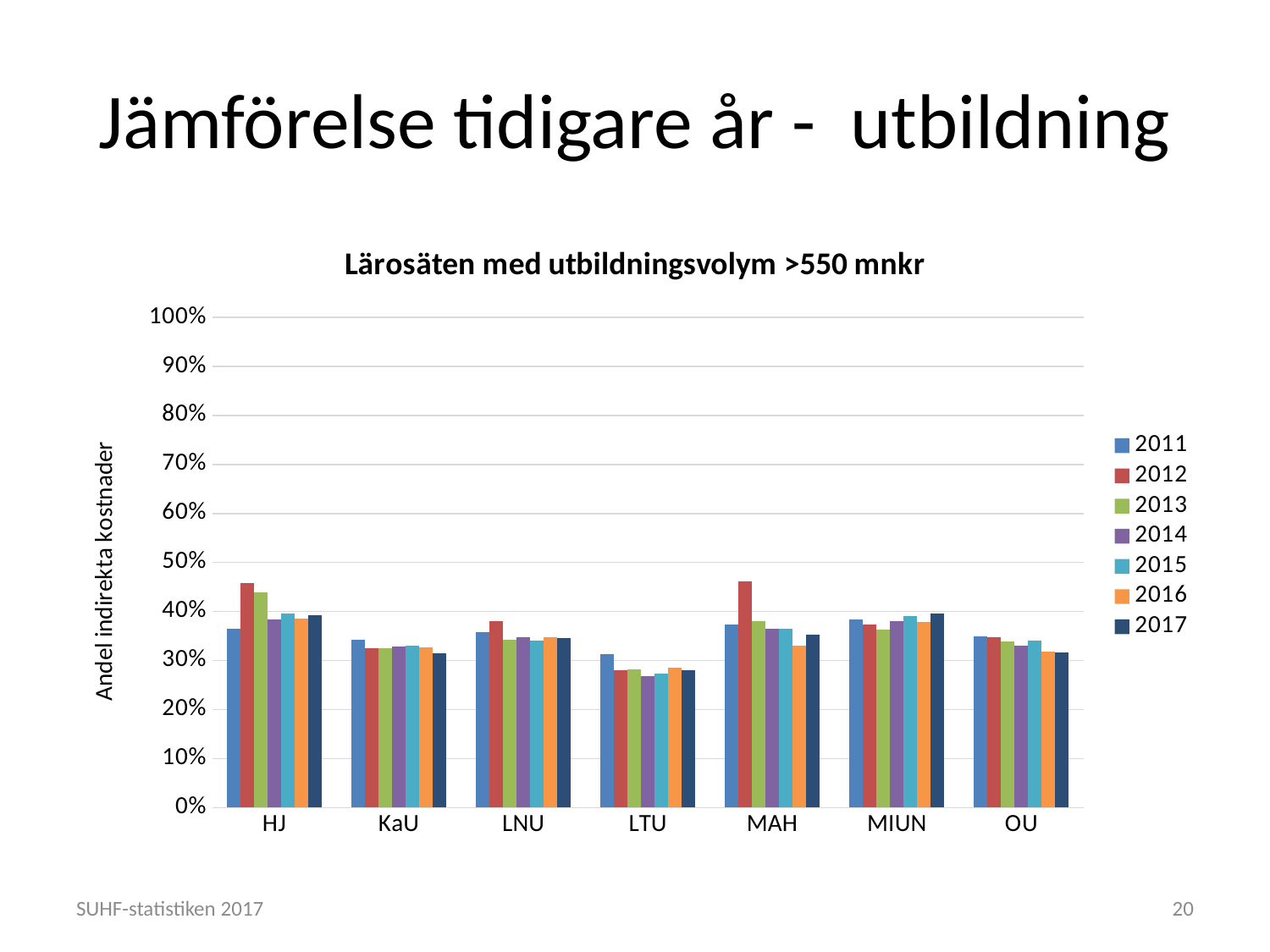
Which institution has the lowest 2011 value? LTU Is the 2017 value for KaU greater or less than 40%? less Is the 2012 value for HJ greater or less than 40%? greater How many institutions (categories) are shown on the x axis? 7 What kind of chart is shown on the slide? bar chart Is the 2012 value for MAH greater or less than 40%? greater What is the title of the chart? Lärosäten med utbildningsvolym >550 mnkr What is the label on the vertical axis? Andel indirekta kostnader How many series does the legend list? 7 Which institution has the lowest 2017 value? LTU Which is larger, the 2012 value for HJ or the 2012 value for KaU? HJ